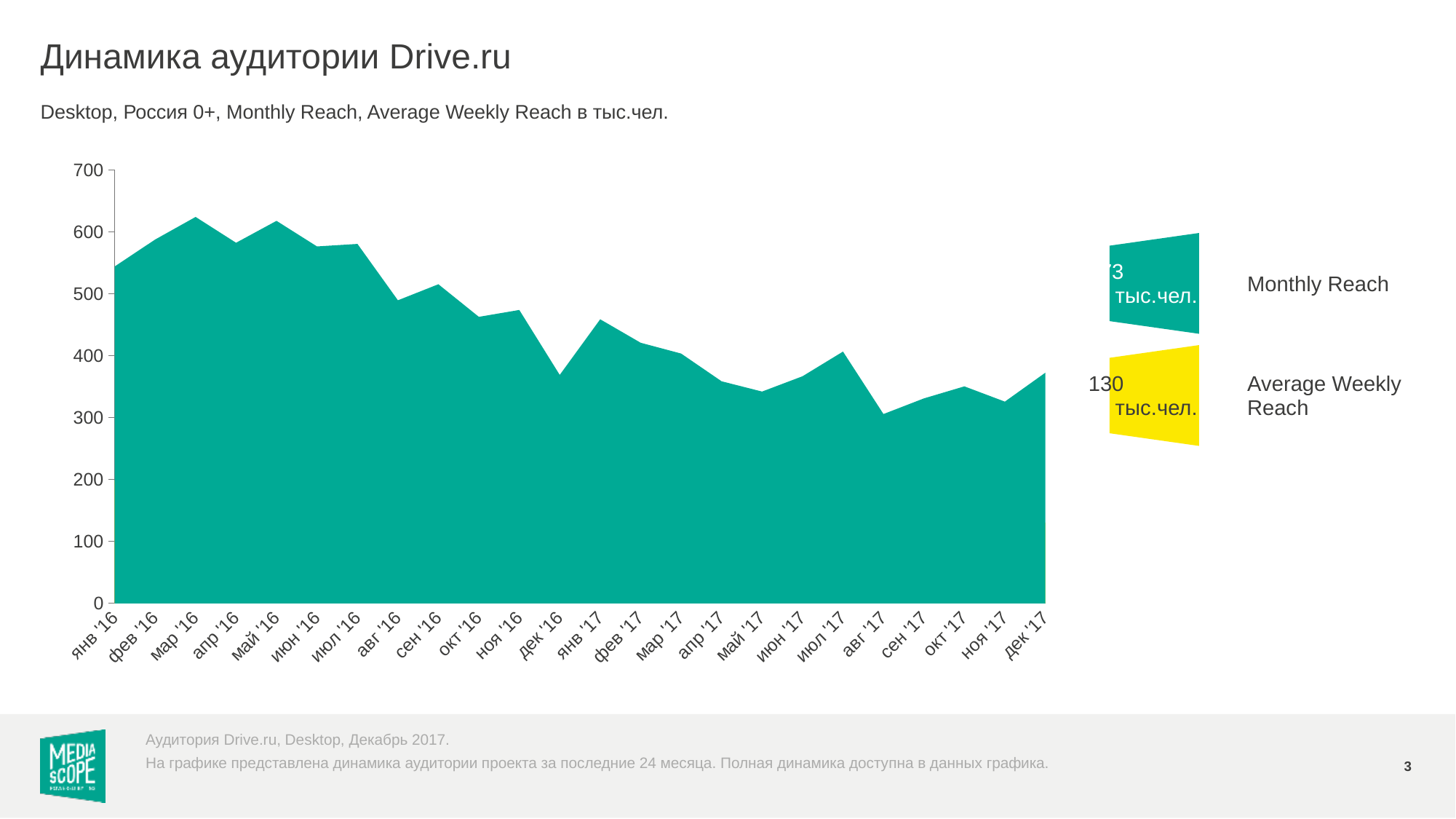
Which month has the larger Monthly Reach value, янв '16 or дек '17? янв '16 Is the Monthly Reach value for дек '16 greater or less than 400? less Is the Monthly Reach value for мар '16 greater or less than 600? greater Is the Monthly Reach value for янв '16 greater or less than 500? greater What Average Weekly Reach value is shown in the yellow box next to the chart? 130 тыс.чел. What is the title of the slide containing the chart? Динамика аудитории Drive.ru What kind of chart is shown on the slide? area chart Which month has the lowest Monthly Reach value on the chart? авг '17 How many months are plotted along the x axis of the chart? 24 Overall, do the Monthly Reach values rise or fall from янв '16 to дек '17? fall